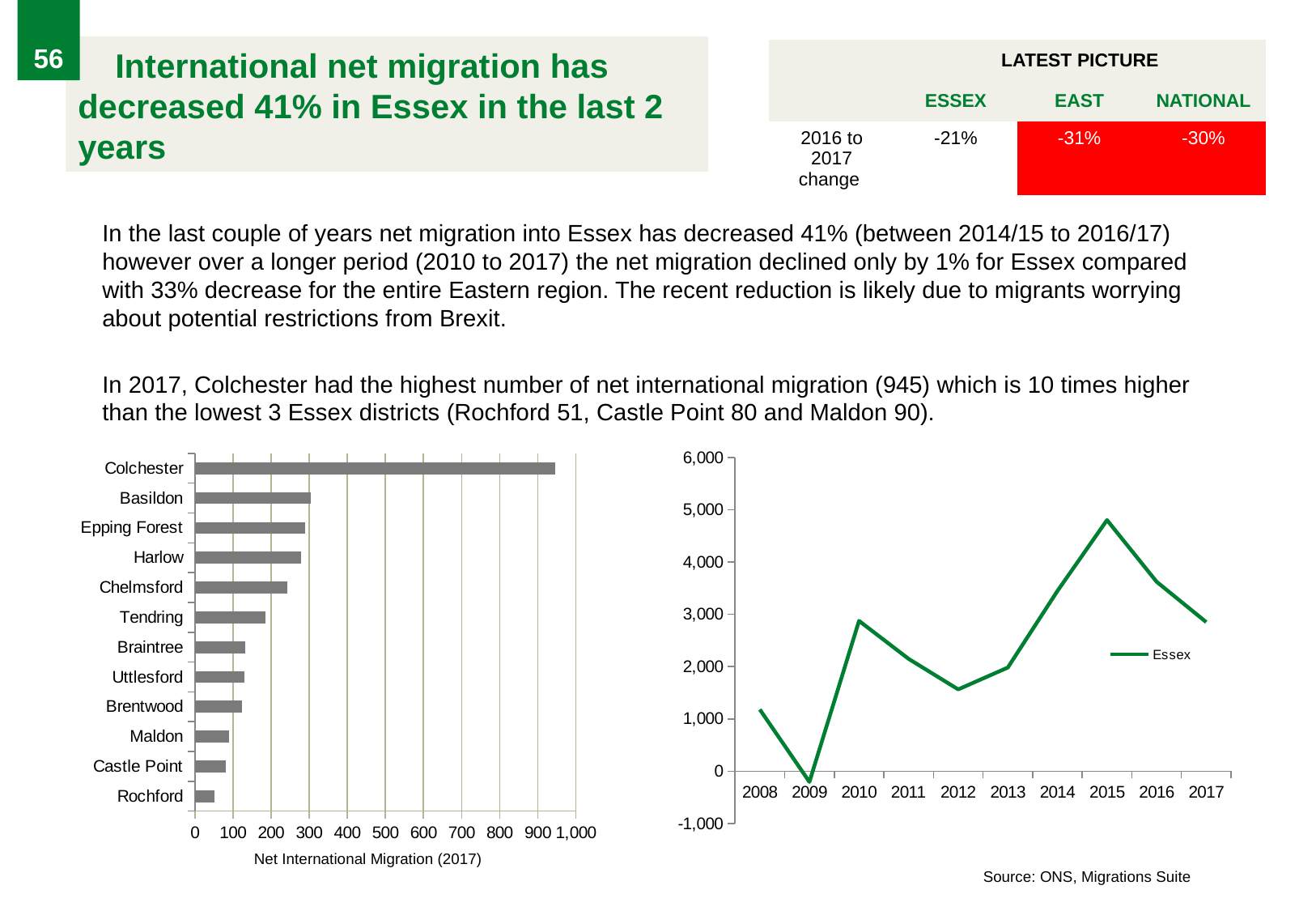
In the Net International Migration (2017) bar chart, which district has the lowest value? Rochford In the Net International Migration (2017) bar chart, what is the value for Colchester? 945 In the Net International Migration (2017) bar chart, which is larger, the value for Chelmsford or the value for Tendring? Chelmsford What kind of chart is the chart on the right of the slide? line chart In the Net International Migration (2017) bar chart, is the value for Tendring greater or less than 100? greater In the line chart on the right, which year has the lowest value for Essex? 2009 In the Net International Migration (2017) bar chart, which district has the highest value? Colchester In the line chart on the right, is the value for Essex in 2015 greater or less than 4,000? greater In the Net International Migration (2017) bar chart, is the value for Basildon greater or less than 400? less In the line chart on the right, which year has the highest value for Essex? 2015 In the Net International Migration (2017) bar chart, how many districts are shown? 12 What kind of chart is the chart on the left of the slide? bar chart